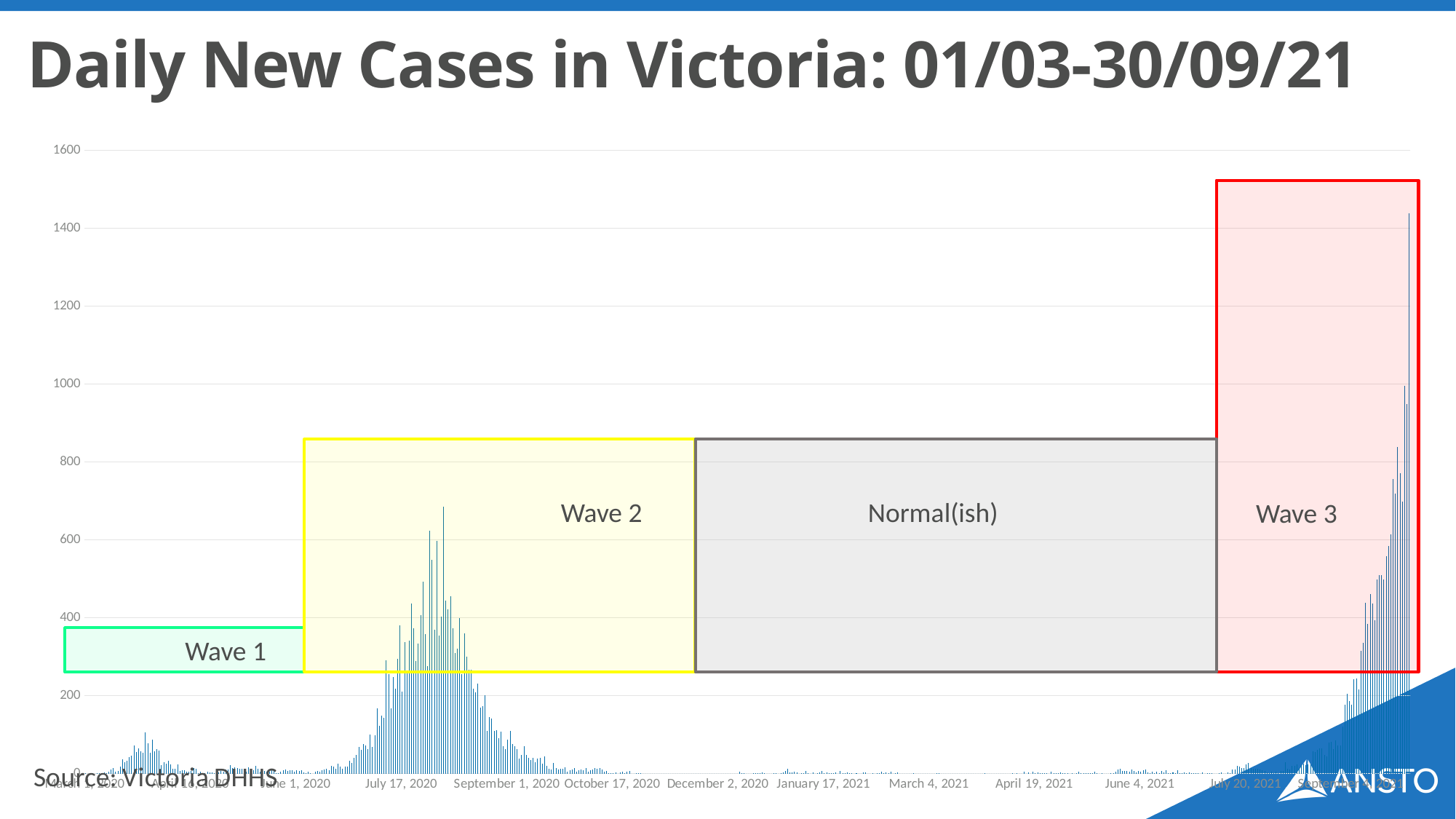
Do daily new cases rise or fall across the Wave 3 period towards the end of the x axis? rise Is the peak of daily new cases in Wave 3 greater or less than 1200? greater What is the highest value shown on the y axis? 1600 Which has the higher peak of daily new cases, Wave 2 or Wave 3? Wave 3 Which labelled period has the highest peak of daily new cases? Wave 3 Is the peak of daily new cases in Wave 2 greater or less than 400? greater What kind of chart is shown on the slide? bar chart How many labelled periods (boxes) are marked on the chart? 4 What is the title of the chart? Daily New Cases in Victoria: 01/03-30/09/21 Is the peak of daily new cases in Wave 1 greater or less than 200? less Which of the three waves has the lowest peak of daily new cases? Wave 1